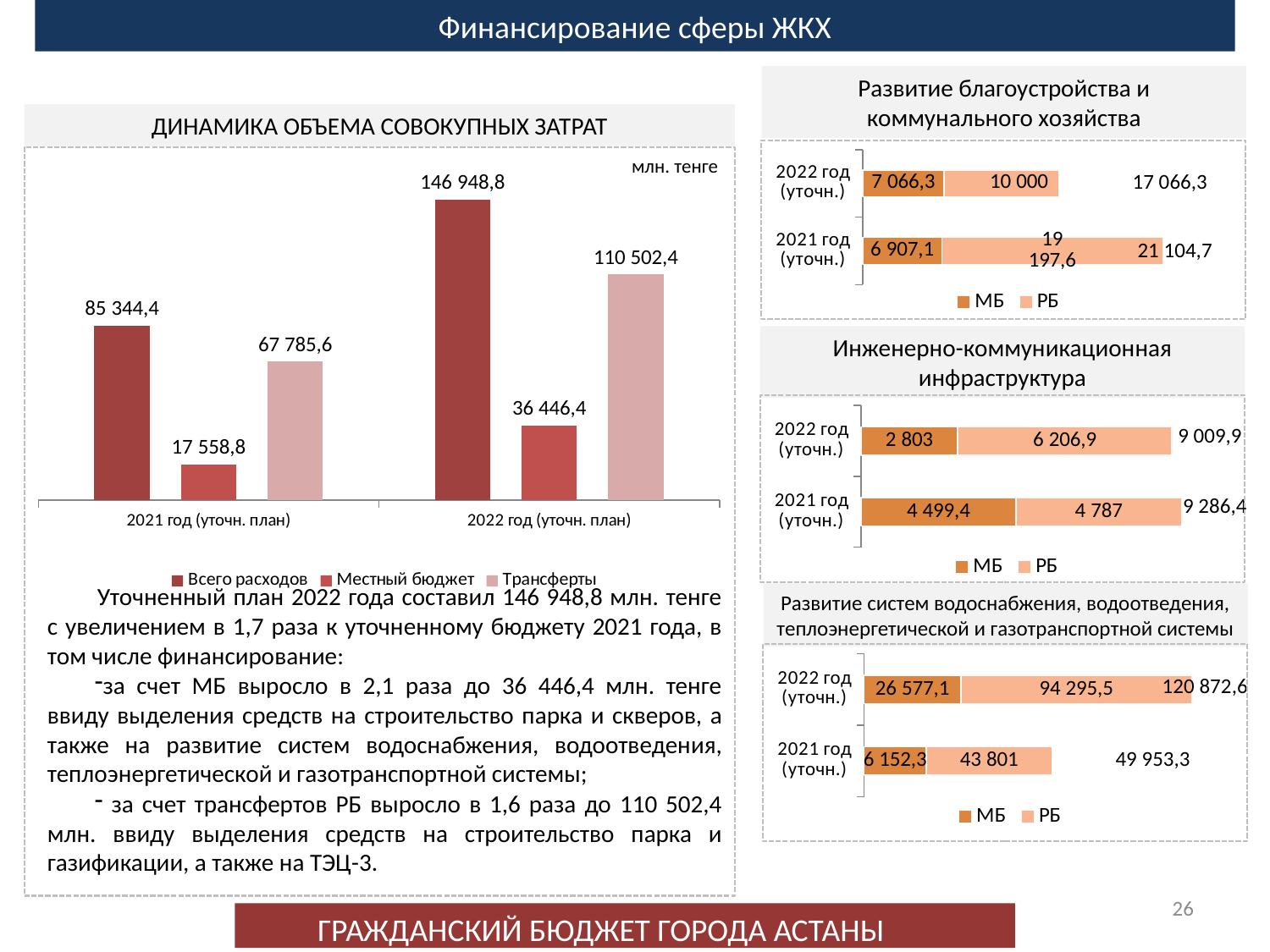
In the chart 'ДИНАМИКА ОБЪЕМА СОВОКУПНЫХ ЗАТРАТ', what is the value of 'Всего расходов' for 2022 год (уточн. план)? 146 948,8 In the chart 'Развитие благоустройства и коммунального хозяйства', what is the total of the stacked bar for 2022 год (уточн.)? 17 066,3 In the chart 'ДИНАМИКА ОБЪЕМА СОВОКУПНЫХ ЗАТРАТ', what is the difference between 'Трансферты' in 2022 and in 2021? 42 716,8 In the chart 'Инженерно-коммуникационная инфраструктура', which year has the larger МБ value, 2022 or 2021? 2021 год (уточн.) What type of chart is 'ДИНАМИКА ОБЪЕМА СОВОКУПНЫХ ЗАТРАТ'? Bar chart In the chart 'Развитие систем водоснабжения, водоотведения, теплоэнергетической и газотранспортной системы', what is the МБ value for 2022 год (уточн.)? 26 577,1 In the chart 'ДИНАМИКА ОБЪЕМА СОВОКУПНЫХ ЗАТРАТ', what unit is shown in the top right corner? млн. тенге In the chart 'ДИНАМИКА ОБЪЕМА СОВОКУПНЫХ ЗАТРАТ', what is the value of 'Местный бюджет' for 2021 год (уточн. план)? 17 558,8 In the chart 'Развитие систем водоснабжения, водоотведения, теплоэнергетической и газотранспортной системы', what is the total of the stacked bar for 2021 год (уточн.)? 49 953,3 In the chart 'Инженерно-коммуникационная инфраструктура', what is the РБ value for 2022 год (уточн.)? 6 206,9 In the chart 'ДИНАМИКА ОБЪЕМА СОВОКУПНЫХ ЗАТРАТ', how many series does the legend list? 3 In the chart 'Развитие благоустройства и коммунального хозяйства', what is the РБ value for 2021 год (уточн.)? 19 197,6